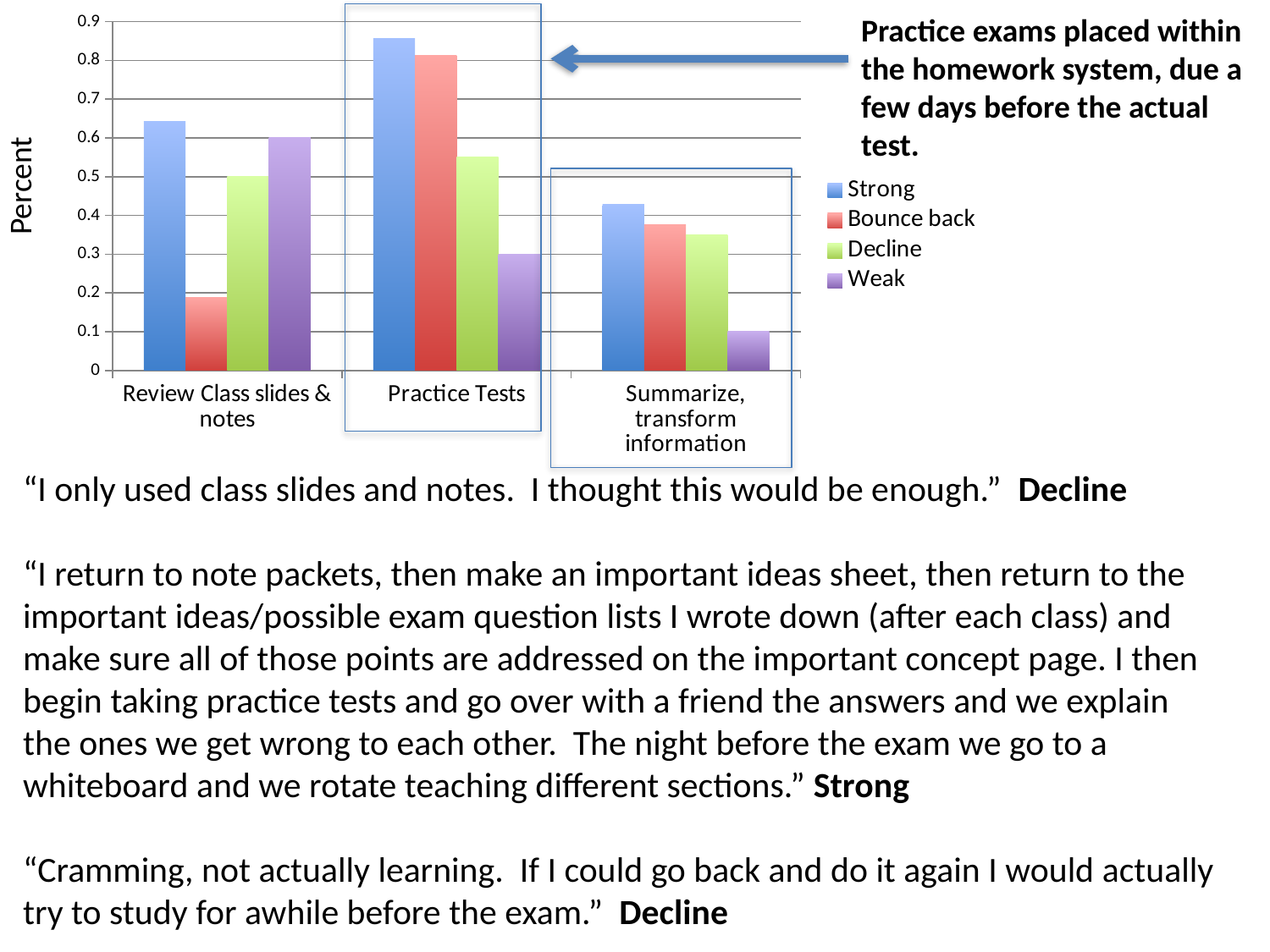
Is the Strong value for Summarize, transform information greater or less than 0.4? greater For Review Class slides & notes, which is larger: the Strong value or the Bounce back value? Strong How many series does the legend list? 4 Which category has the lowest Weak bar? Summarize, transform information Which category has the highest Strong bar? Practice Tests What kind of chart is shown on the slide? bar chart Is the Decline value for Practice Tests greater or less than 0.5? greater For Practice Tests, which is larger: the Decline value or the Weak value? Decline Is the Strong value for Practice Tests greater or less than 0.8? greater What is the label on the y axis of the chart? Percent How many categories are shown on the x axis? 3